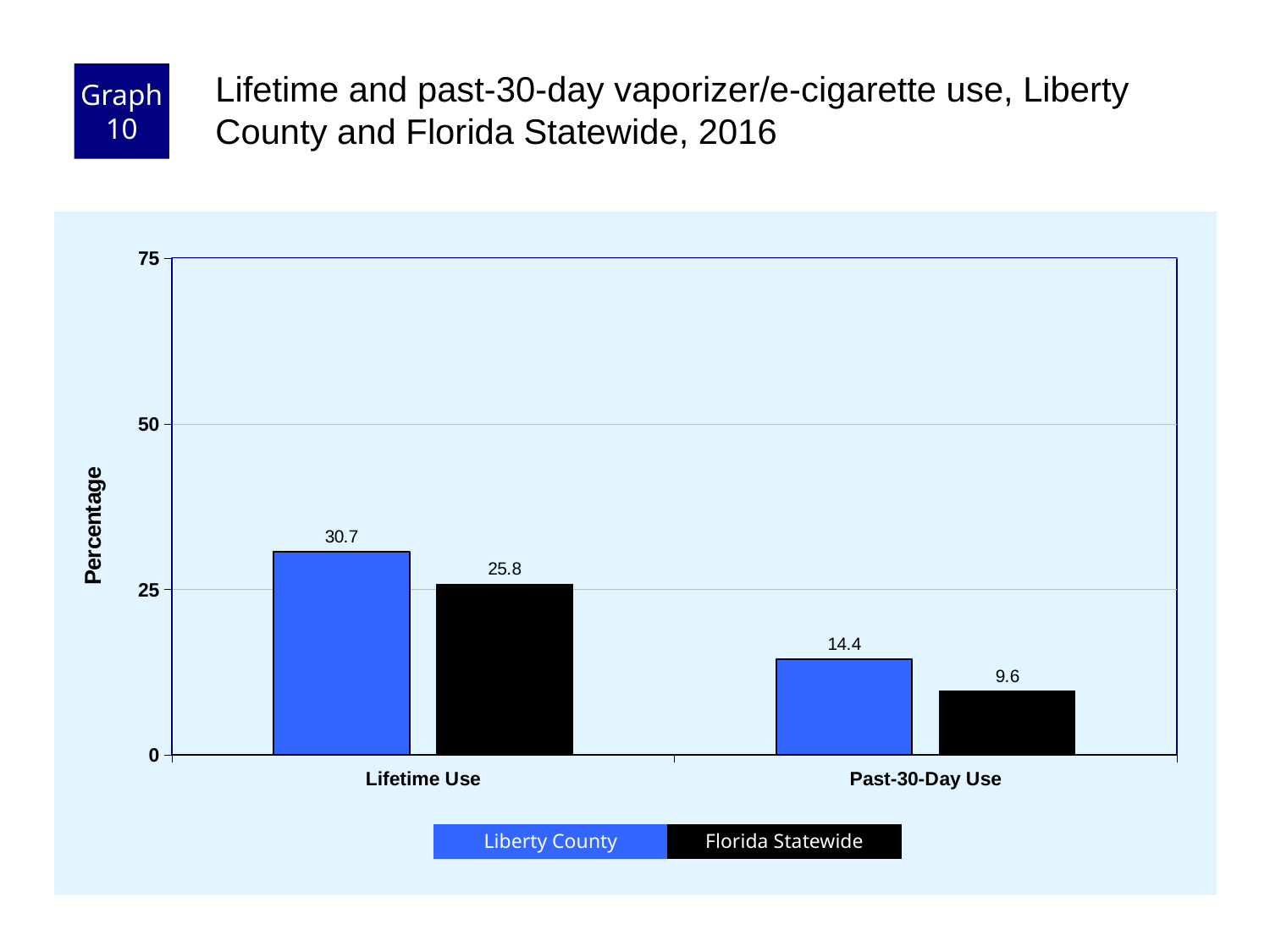
Which bar has the lowest value on the chart? Florida Statewide, Past-30-Day Use What kind of chart is shown on the slide? Bar chart Which bar has the highest value on the chart? Liberty County, Lifetime Use What is the Florida Statewide value for Past-30-Day Use? 9.6 What is the Liberty County value for Past-30-Day Use? 14.4 Which is larger for Past-30-Day Use, Liberty County or Florida Statewide? Liberty County What is the difference between the Liberty County and Florida Statewide values for Past-30-Day Use? 4.8 How many series does the legend list? 2 What is the difference between the Liberty County and Florida Statewide values for Lifetime Use? 4.9 What is the Liberty County value for Lifetime Use? 30.7 What is the Florida Statewide value for Lifetime Use? 25.8 What is the label on the vertical axis? Percentage